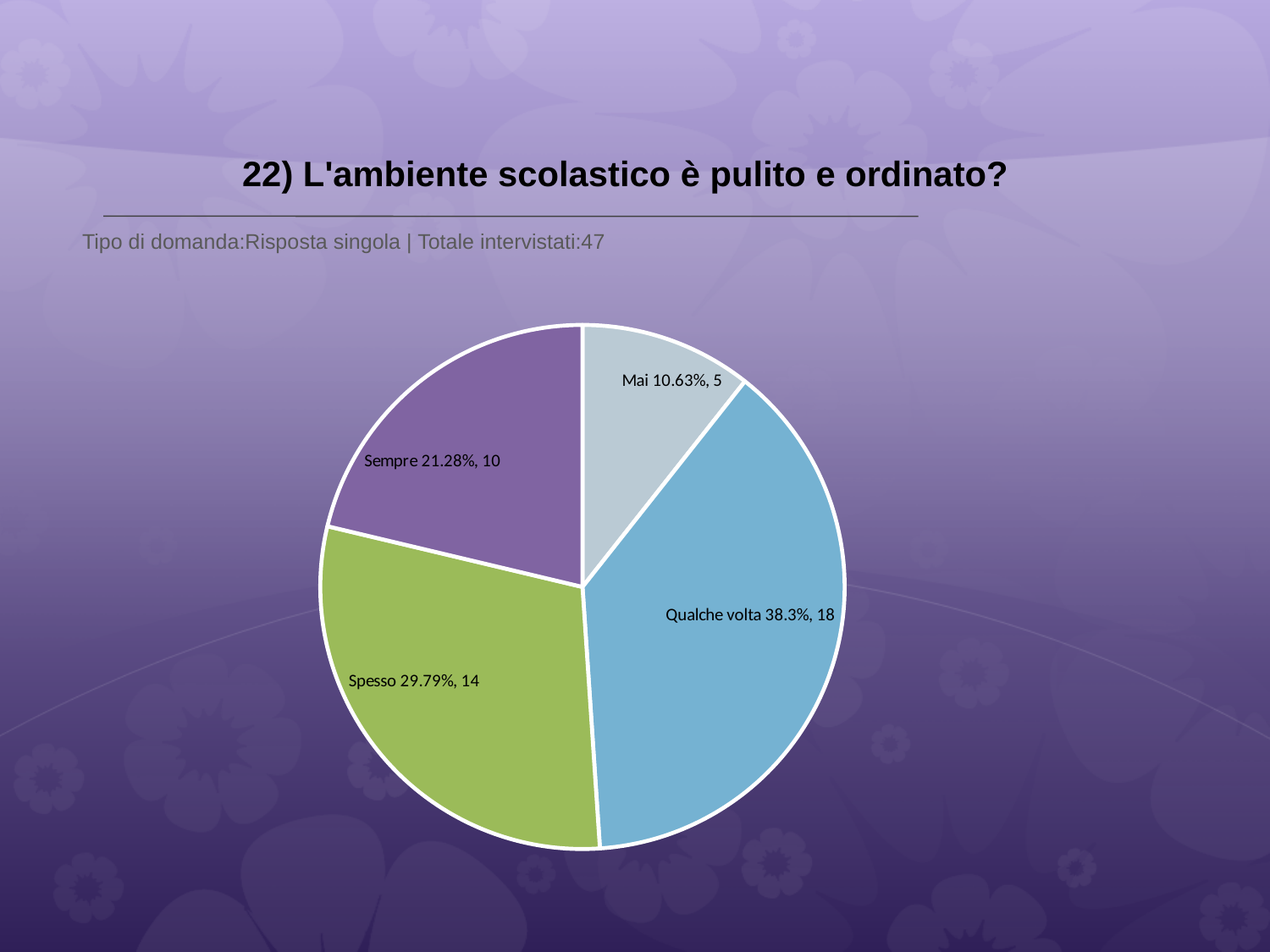
Which has more respondents, 'Spesso' or 'Sempre'? Spesso What kind of chart is shown on the slide? pie chart What percentage share does the 'Sempre' slice have? 21.28% How many respondents answered 'Spesso'? 14 How many respondents answered 'Mai'? 5 How many slices does the pie chart have? 4 Which category has the smallest slice of the pie? Mai Which category has the largest slice of the pie? Qualche volta What is the total number of respondents across all slices? 47 What is the title of the chart on the slide? 22) L'ambiente scolastico è pulito e ordinato? What is the difference in respondent count between 'Qualche volta' and 'Sempre'? 8 What percentage share does the 'Qualche volta' slice have? 38.3%